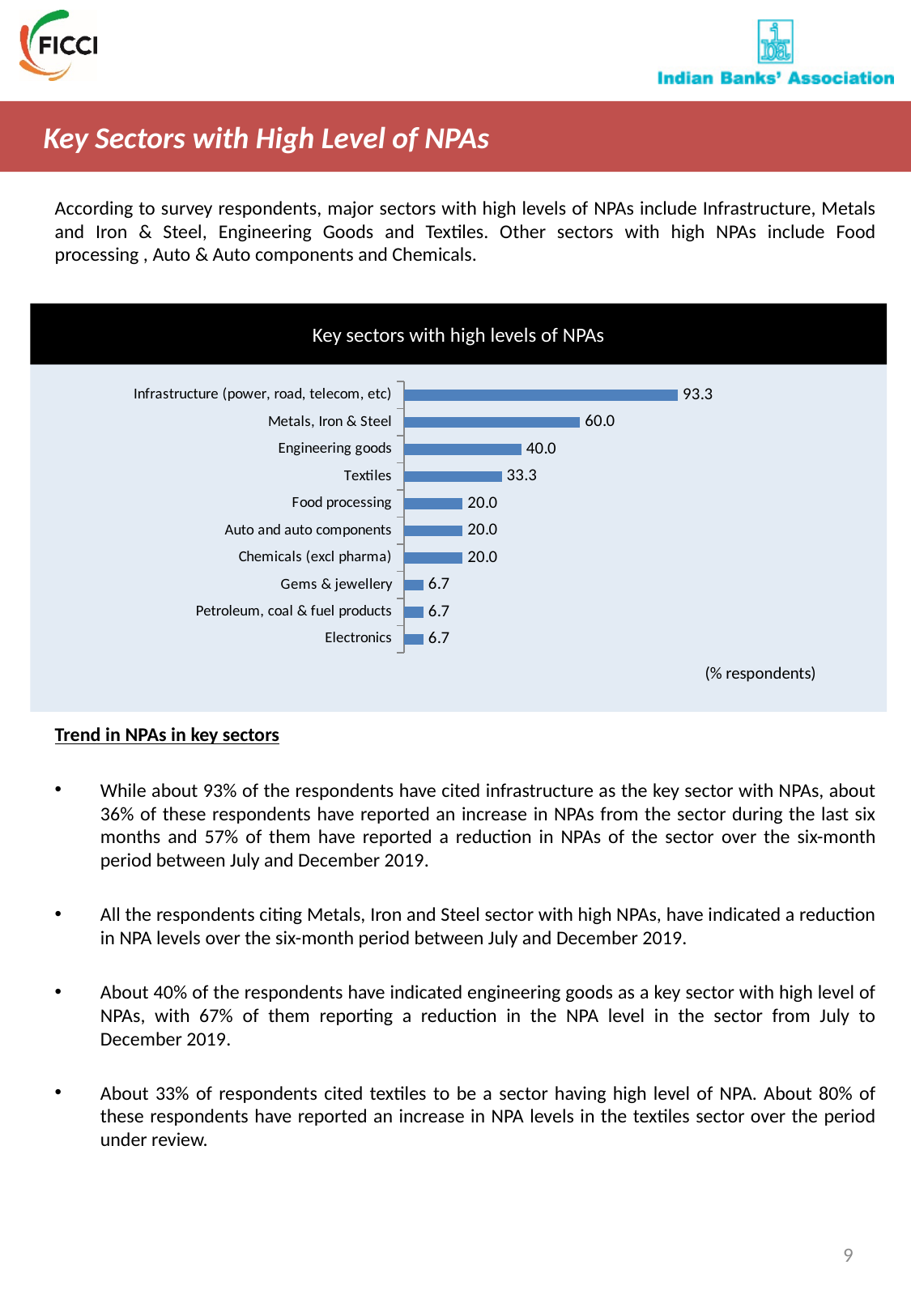
What is the title of the chart? Key sectors with high levels of NPAs What unit is indicated for the values in the chart? % respondents Which is larger, the value for Engineering goods or the value for Textiles? Engineering goods What is the value for Metals, Iron & Steel? 60.0 What is the value for Food processing? 20.0 Which sector has the highest value? Infrastructure (power, road, telecom, etc) What is the value for Infrastructure (power, road, telecom, etc)? 93.3 What is the value for Textiles? 33.3 What kind of chart is this? Bar chart How many sectors are shown in the chart? 10 What is the difference between the values for Infrastructure (power, road, telecom, etc) and Electronics? 86.6 What is the difference between the values for Metals, Iron & Steel and Engineering goods? 20.0